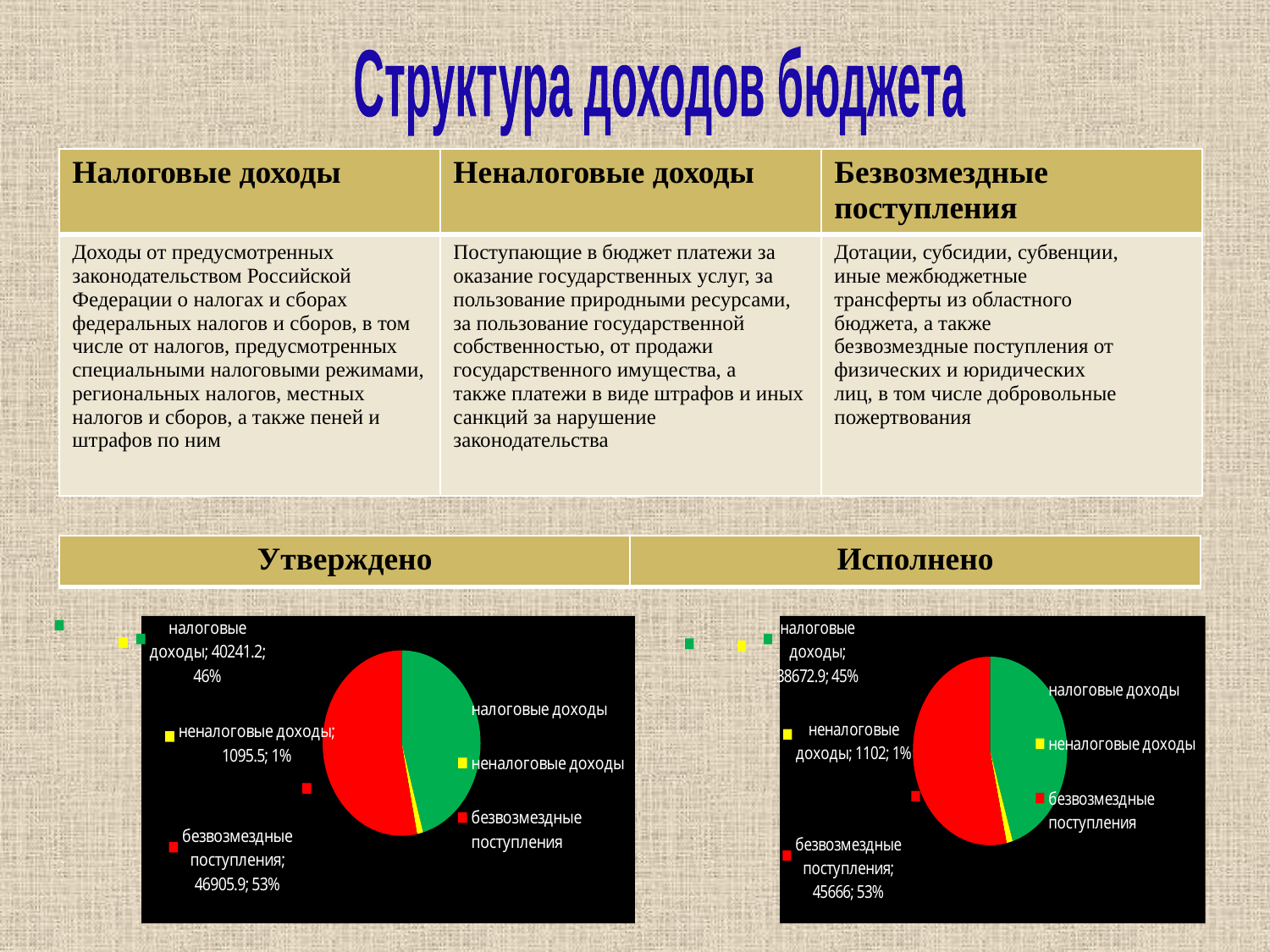
In the "Исполнено" pie chart, what is the value for неналоговые доходы? 1102 In the "Исполнено" pie chart, what share of the pie is налоговые доходы? 45% In the "Исполнено" pie chart, which is larger: налоговые доходы or безвозмездные поступления? безвозмездные поступления What type of chart is shown under "Утверждено"? pie chart In the "Утверждено" pie chart, which category has the largest slice? безвозмездные поступления In the "Утверждено" pie chart, what share of the pie is безвозмездные поступления? 53% In the "Утверждено" pie chart, what is the value for налоговые доходы? 40241.2 How many categories does the "Исполнено" pie chart have? 3 In the "Утверждено" pie chart, which category has the smallest slice? неналоговые доходы In the "Исполнено" pie chart, what colour is the slice for неналоговые доходы? yellow In the "Исполнено" pie chart, what is the value for безвозмездные поступления? 45666 In the "Утверждено" pie chart, what is the value for неналоговые доходы? 1095.5